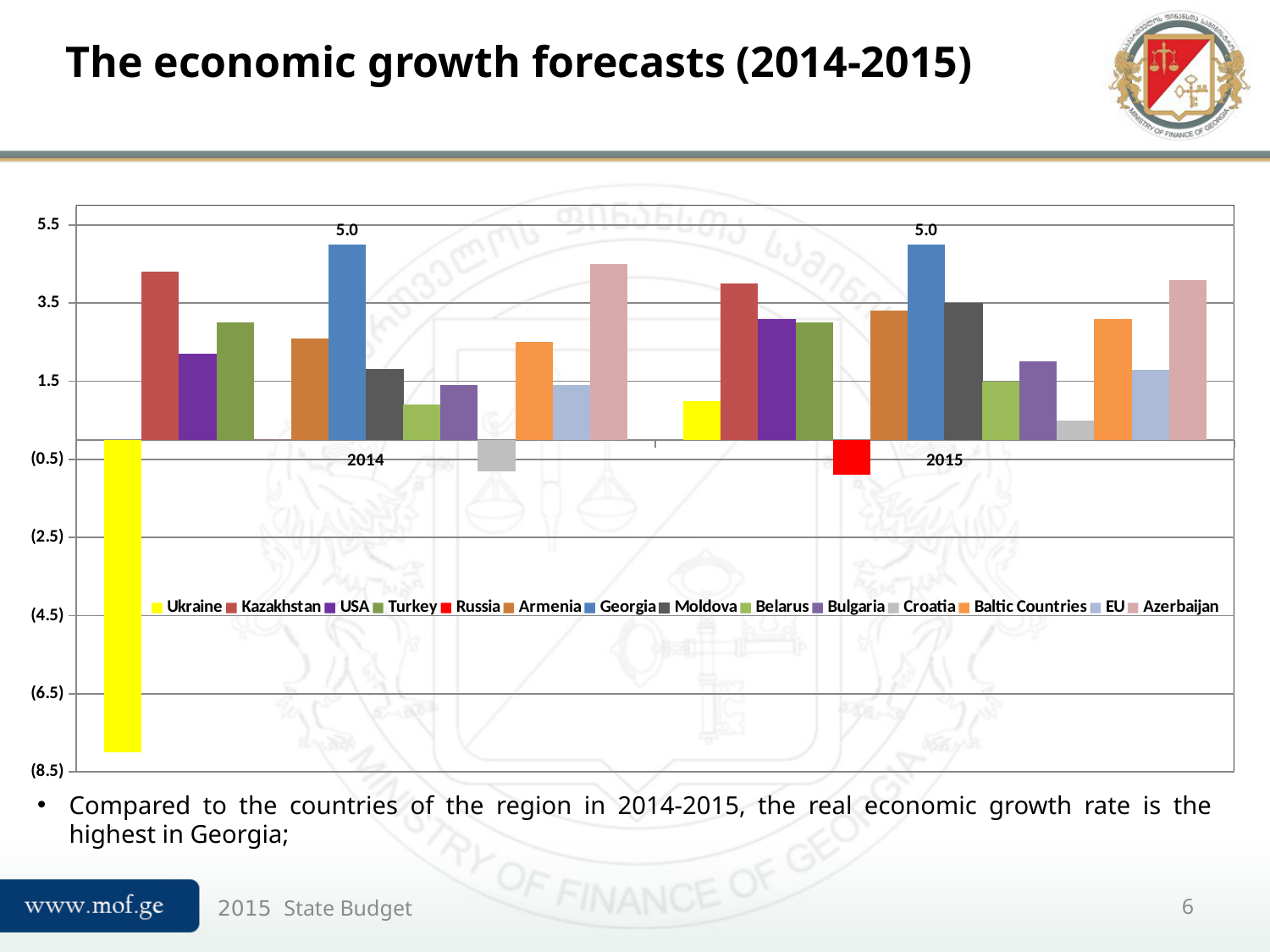
Which country has the lowest forecast value in 2014? Ukraine Which is larger: the value for Moldova in 2014 or in 2015? 2015 Which country has the lowest forecast value in 2015? Russia Is the value for Kazakhstan in 2014 greater or less than 3.5? greater Is the value for Ukraine in 2014 greater or less than (6.5)? less What is the forecast value for Georgia in 2014? 5.0 What kind of chart is shown on the slide? Bar chart Does the value for Georgia rise, fall or stay the same from 2014 to 2015? Stays the same Which country has the highest forecast value in 2014? Georgia What is the forecast value for Georgia in 2015? 5.0 How many series does the legend list? 14 How many year categories are shown on the x axis? 2